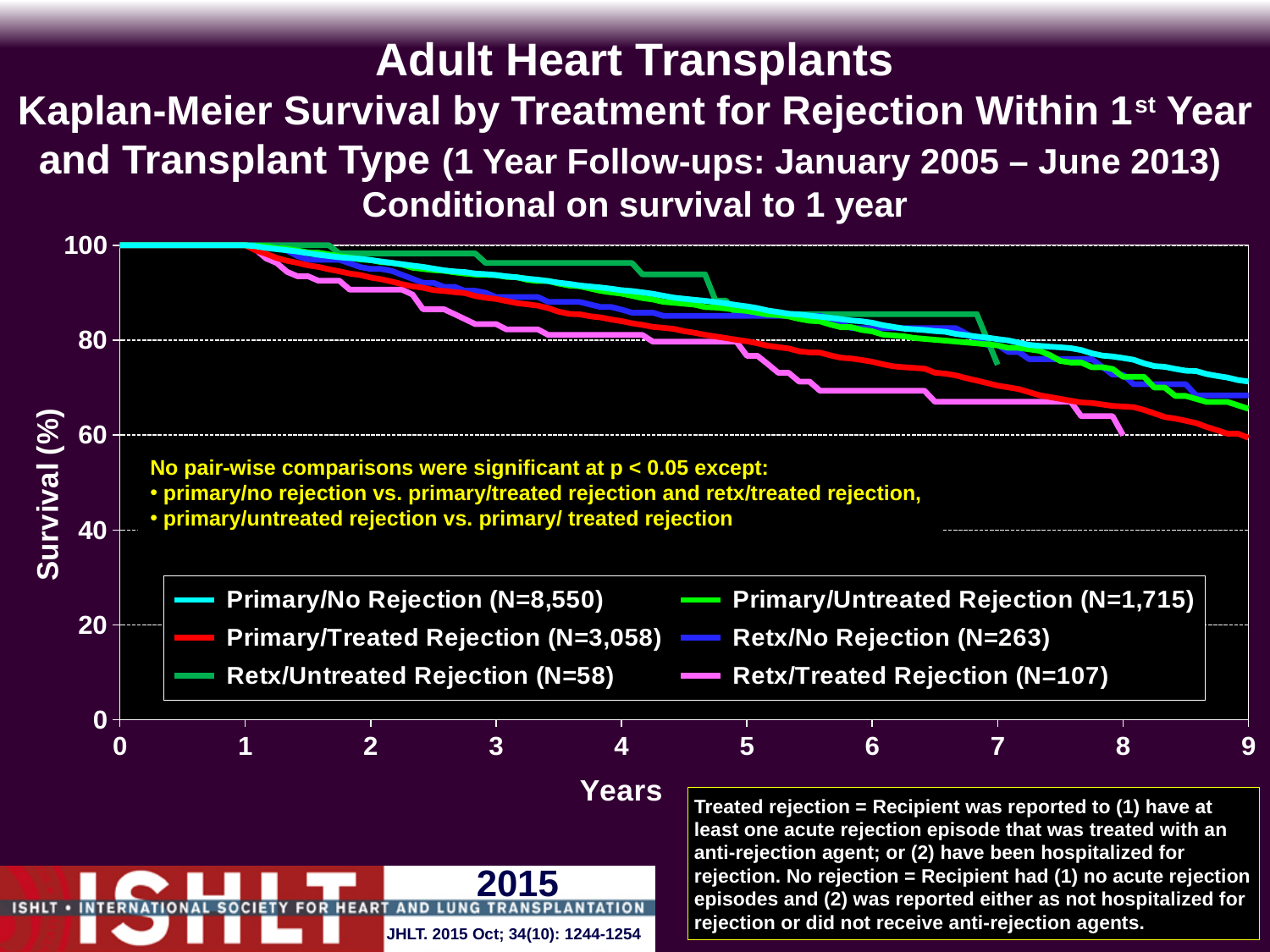
Is the survival value for Retx/Treated Rejection at year 7 greater or less than 80? less Which series in the legend has the largest N? Primary/No Rejection (N=8,550) What kind of chart is shown on the slide? line chart Which series has the highest survival at year 3? Retx/Untreated Rejection Which series has the lowest survival at year 8? Retx/Treated Rejection Is the survival value for Retx/Untreated Rejection at year 3 greater or less than 80? greater Is the survival value for Primary/Treated Rejection at year 3 greater or less than 80? greater Do the survival curves rise or fall as the years increase? fall At year 8, which has higher survival: Primary/No Rejection or Primary/Treated Rejection? Primary/No Rejection At year 5, which has higher survival: Primary/No Rejection or Retx/Treated Rejection? Primary/No Rejection How many series does the legend list? 6